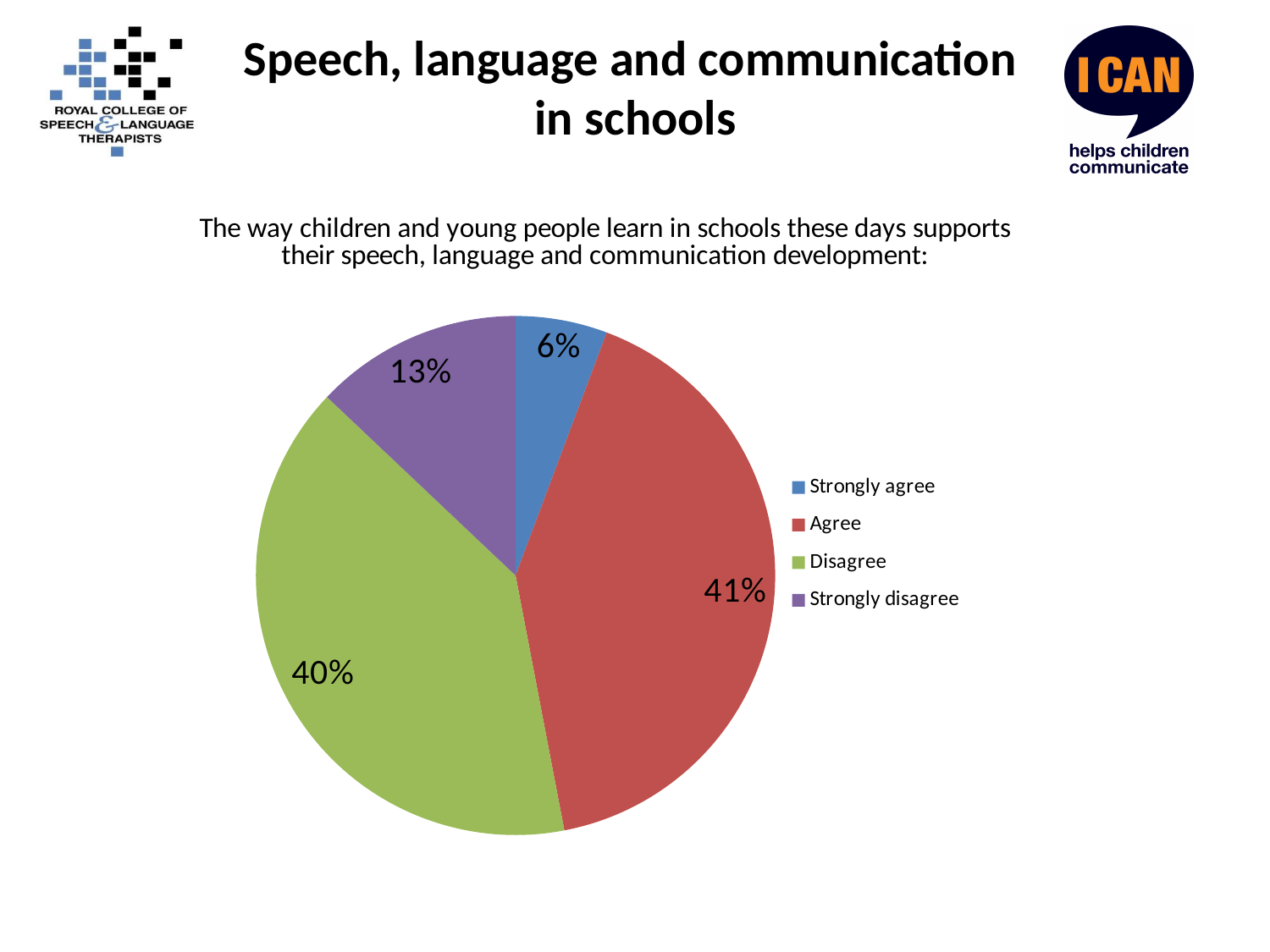
How many entries does the legend list? 4 What percentage of respondents chose Strongly agree? 6% What percentage of respondents chose Disagree? 40% What type of chart is shown on the slide? Pie chart What percentage of respondents chose Strongly disagree? 13% Which is larger, the share for Strongly disagree or the share for Strongly agree? Strongly disagree What percentage of respondents chose Agree? 41% What is the difference in percentage points between Strongly disagree and Strongly agree? 7% What is the difference in percentage points between Agree and Strongly agree? 35% What is the combined share of Strongly agree and Agree? 47% Which response has the smallest share of the pie? Strongly agree How many slices does the pie chart have? 4